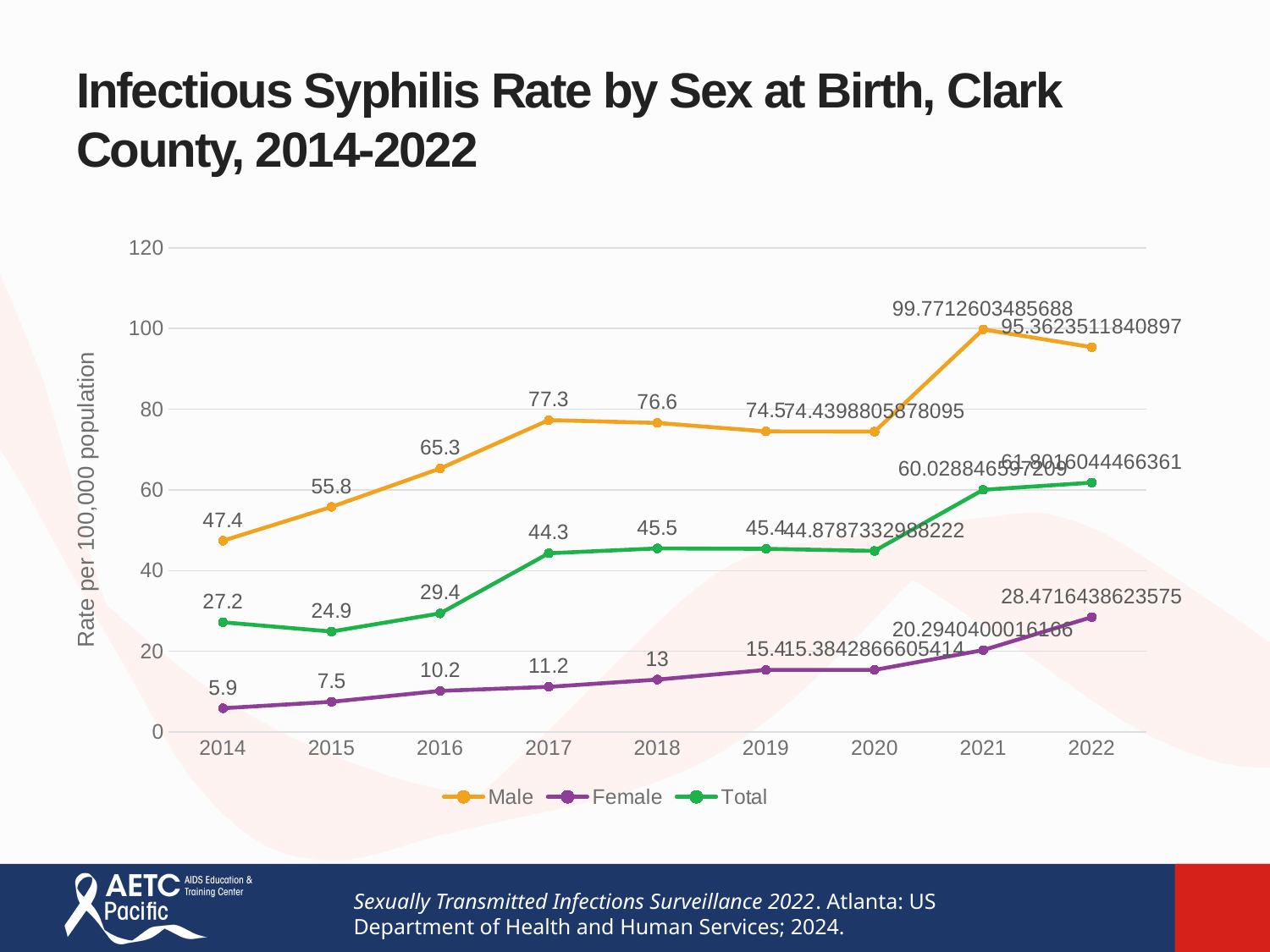
What is the Male rate in 2014? 47.4 What is the Total rate in 2017? 44.3 In which year is the Male rate highest? 2021 What is the difference between the Male rate in 2017 and in 2016? 12 Which is larger, the Female rate in 2016 or in 2017? 2017 Is the Female value for 2022 greater or less than 20? greater What is the Female rate in 2018? 13 What kind of chart is shown on the slide? line chart How many series does the legend list? 3 How many years are plotted along the x axis? 9 In which year is the Total rate lowest? 2015 What is the Male rate in 2022? 95.3623511840897